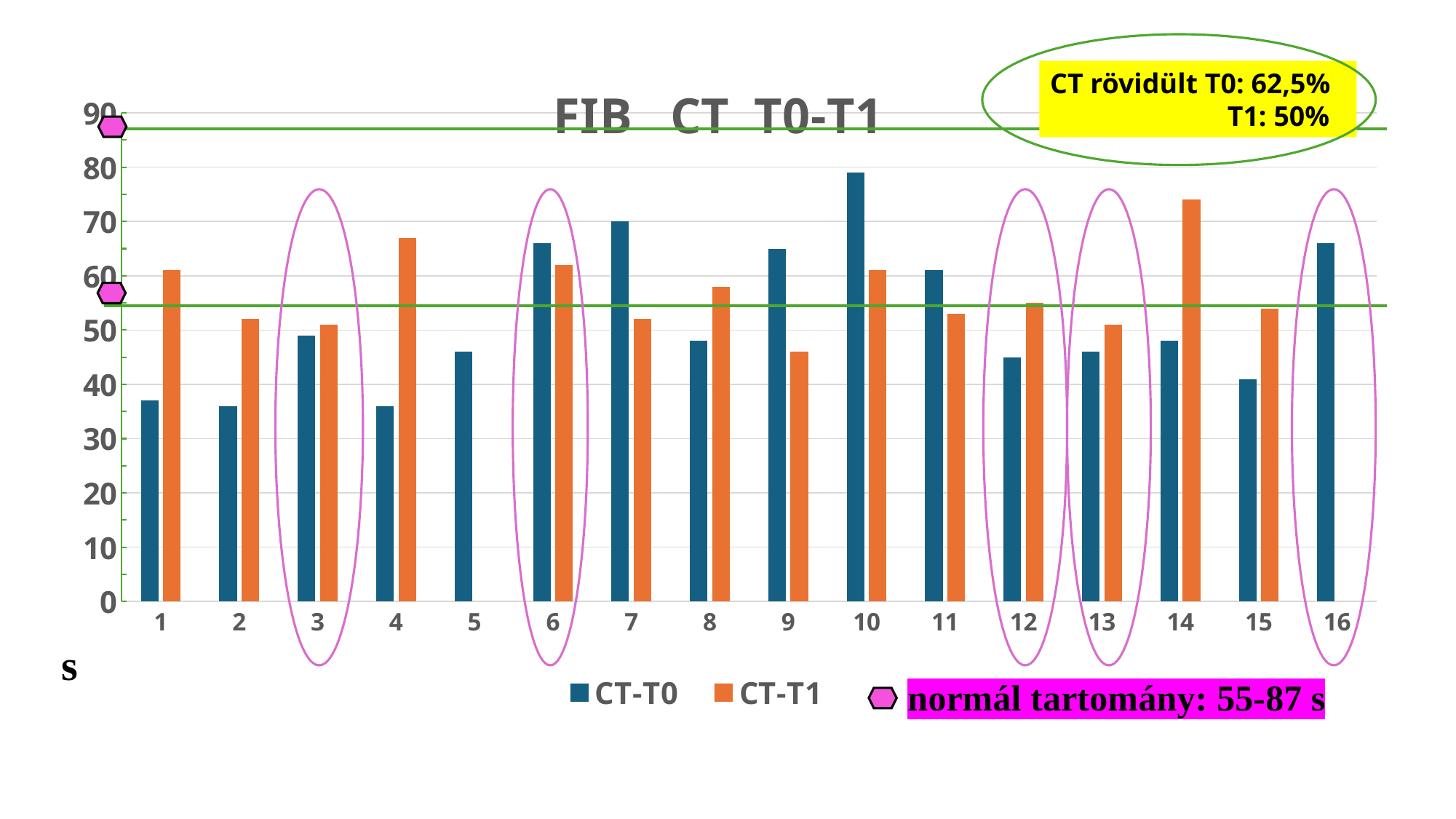
Which category has the lowest CT-T1 value among those with a CT-T1 bar? 9 Is the CT-T0 value for category 10 greater or less than 70? greater For category 10, which series has the larger value, CT-T0 or CT-T1? CT-T0 For category 1, which series has the larger value, CT-T0 or CT-T1? CT-T1 Is the CT-T0 value for category 1 greater or less than 40? less How many categories are shown on the x axis? 16 What kind of chart is shown on the slide? bar chart Which category has the highest CT-T1 value? 14 Is the CT-T1 value for category 14 greater or less than 70? greater What is the title of the chart? FIB CT T0-T1 Which category has the highest CT-T0 value? 10 How many series does the legend list? 2